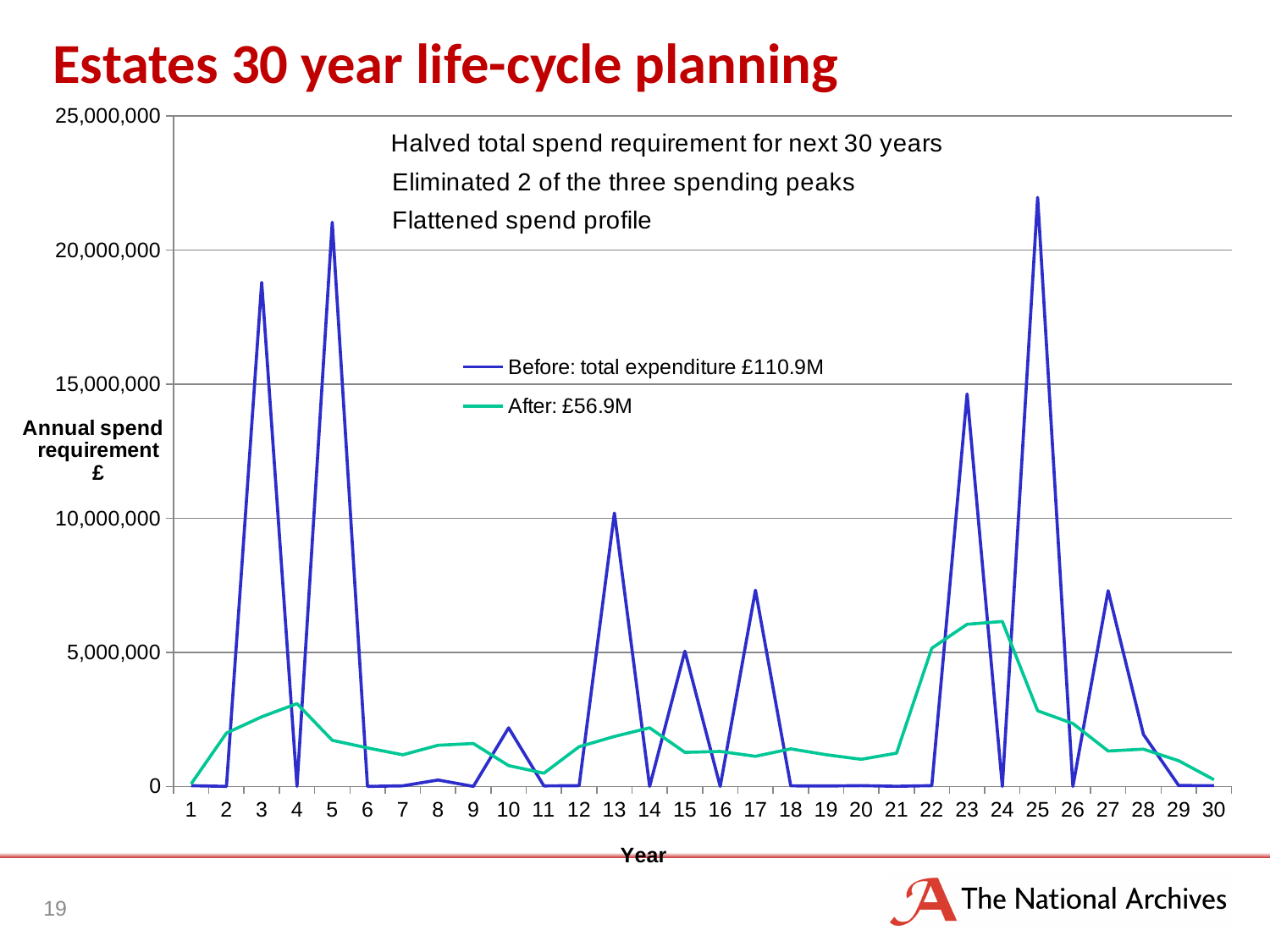
Is the 'Before' value for year 13 greater or less than 5,000,000? greater In year 4, which series has the larger value, 'Before' or 'After'? After What kind of chart is shown on the slide? line chart Is the 'After' value for year 4 greater or less than 5,000,000? less How many series does the legend list? 2 Is the 'Before' value for year 17 greater or less than 5,000,000? greater In year 25, which series has the larger value, 'Before' or 'After'? Before In which year does the 'Before' series reach its highest value? 25 How many years are plotted along the x axis? 30 According to the legend, what is the total expenditure for the 'After' series? £56.9M